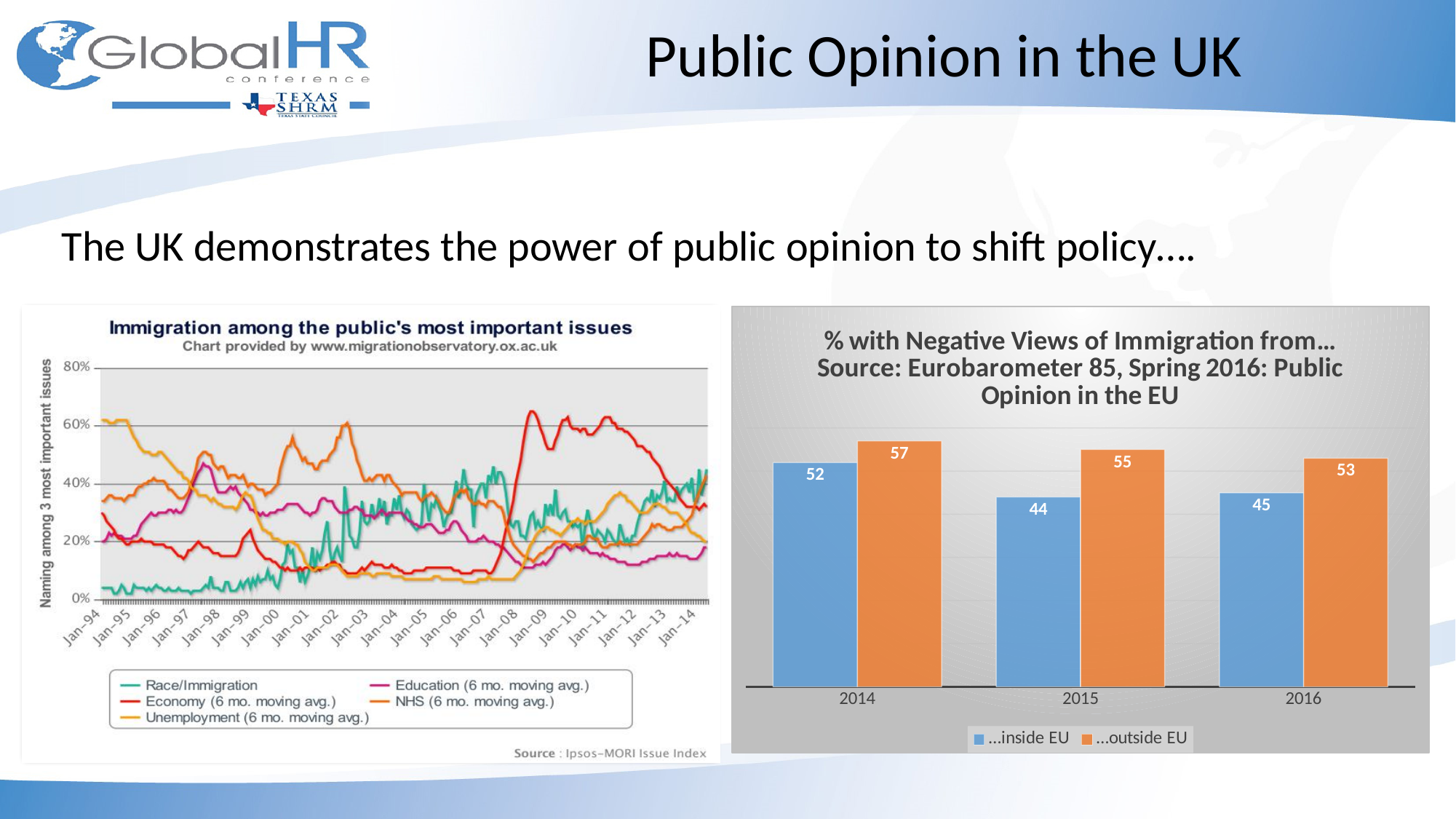
On the right-hand chart, which year has the lowest value for ...inside EU? 2015 On the right-hand chart, what is the value for ...outside EU in 2015? 55 How many series does the legend of the right-hand chart list? 2 What kind of chart is the right-hand chart? Bar chart On the right-hand chart, what is the value for ...inside EU in 2014? 52 On the right-hand chart, which is larger in 2016: ...inside EU or ...outside EU? ...outside EU On the right-hand chart, what is the value for ...inside EU in 2016? 45 On the right-hand chart, what is the difference between the ...outside EU and ...inside EU values in 2015? 11 On the left-hand chart, is the value for Race/Immigration at Jan-94 greater or less than 20%? less How many series does the legend of the left-hand chart list? 5 What kind of chart is the left-hand chart titled 'Immigration among the public's most important issues'? Line chart On the right-hand chart, which year has the highest value for ...outside EU? 2014